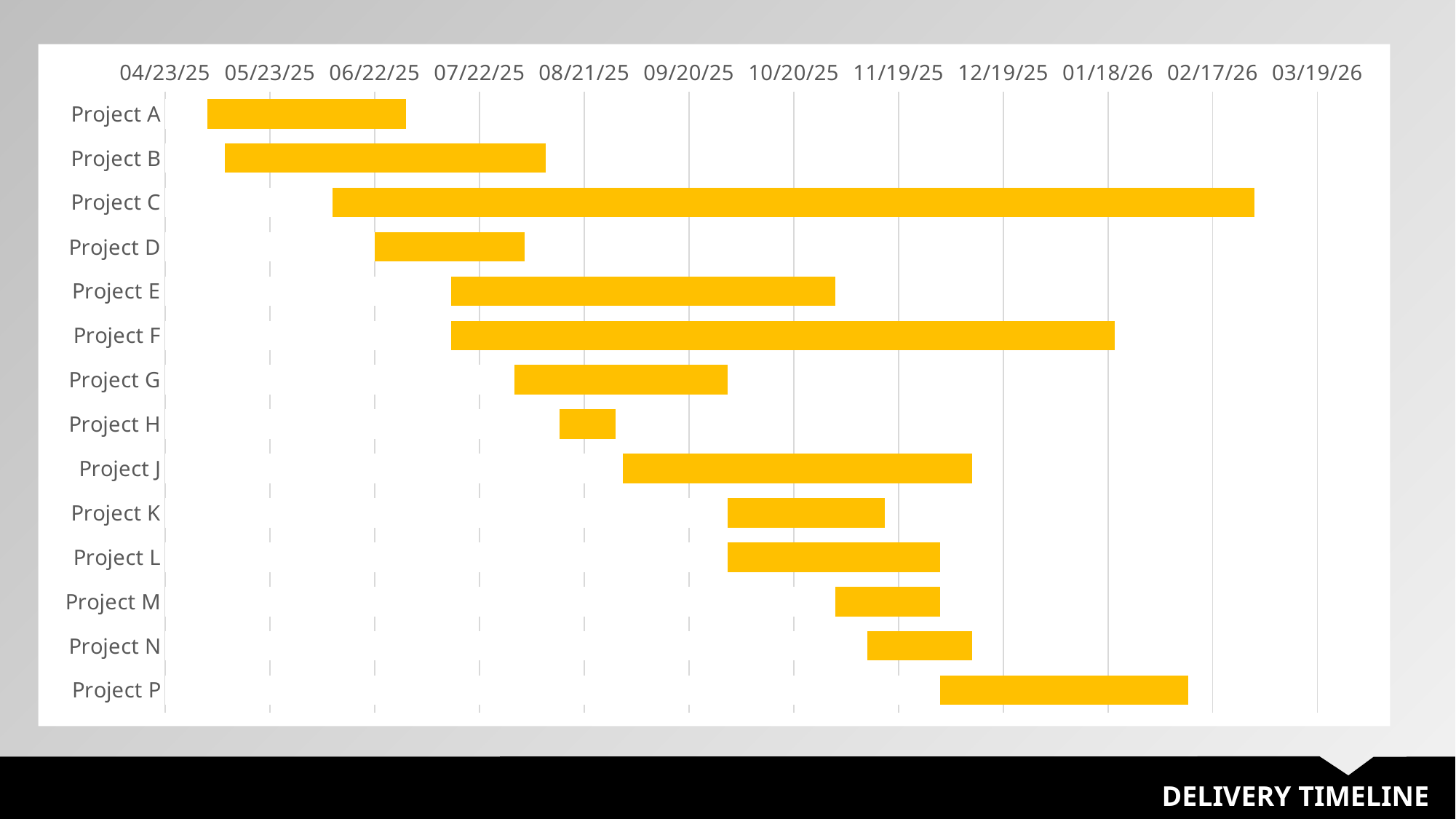
Does Project B end before or after 08/21/25? before Which project starts latest on the timeline? Project P How many projects are listed on the chart? 14 Which project has the shortest bar on the timeline? Project H Does Project H start before or after 07/22/25? after Which project starts earliest on the timeline? Project A Which bar is longer, Project C or Project D? Project C Which bar is longer, Project J or Project K? Project J Does Project C end before or after 02/17/26? after What kind of chart is shown on the slide? Bar chart (Gantt chart) What is the title shown at the bottom of the slide? DELIVERY TIMELINE Which project has the longest bar on the timeline? Project C